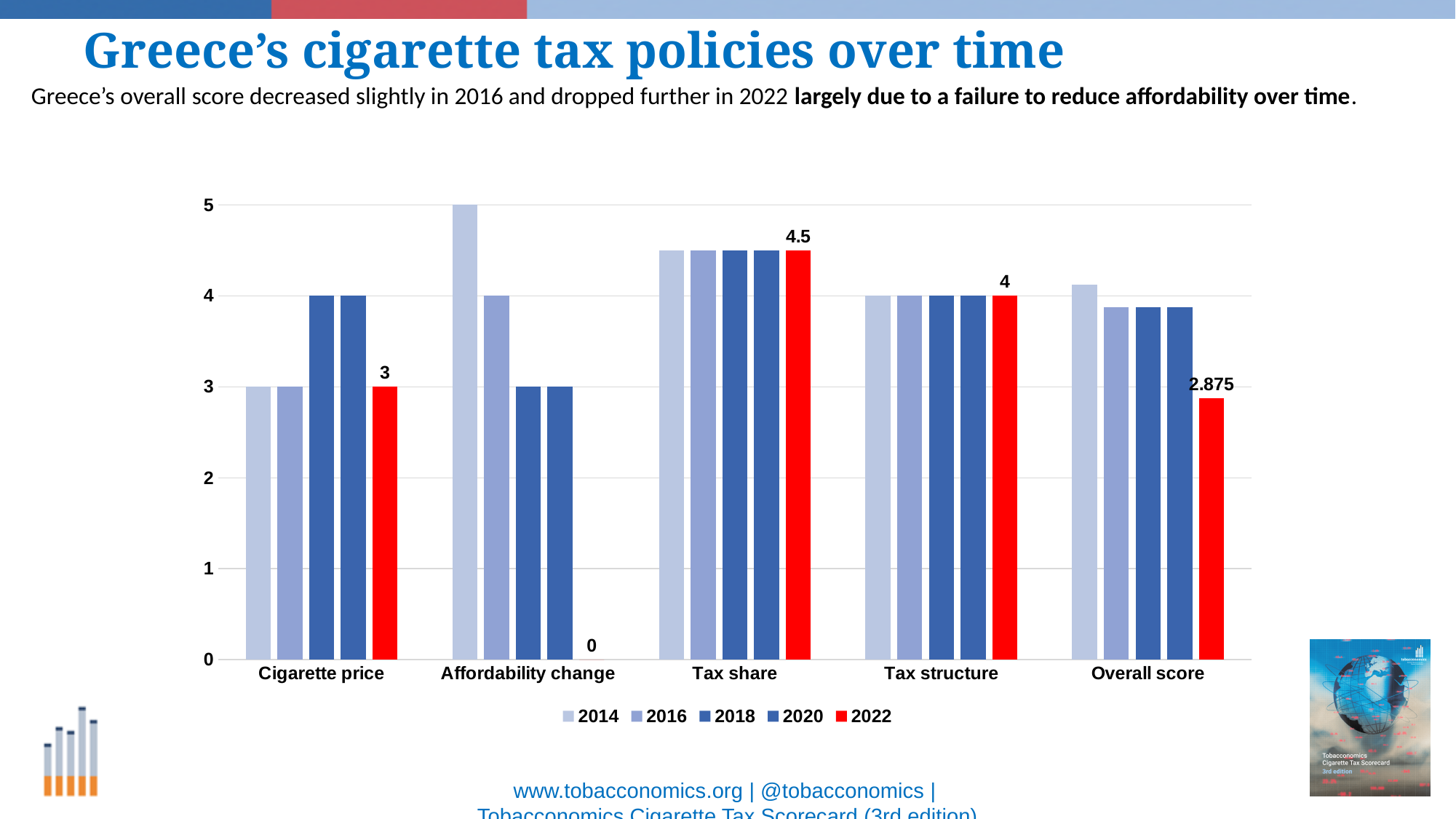
What is the value for Tax share in 2022? 4.5 What is the value for Affordability change in 2022? 0 What is the difference between the 2022 values for Tax share and Overall score? 1.625 What is the value for Affordability change in 2014? 5 Which category has the lowest value for 2022? Affordability change Which category has the highest value for 2022? Tax share What is the value for Cigarette price in 2018? 4 Which is larger in 2022: Cigarette price or Tax structure? Tax structure Is the value for Overall score in 2014 greater or less than 4? greater Do the values for Affordability change rise or fall from 2014 to 2022? fall How many series does the legend list? 5 What is the value for Overall score in 2022? 2.875